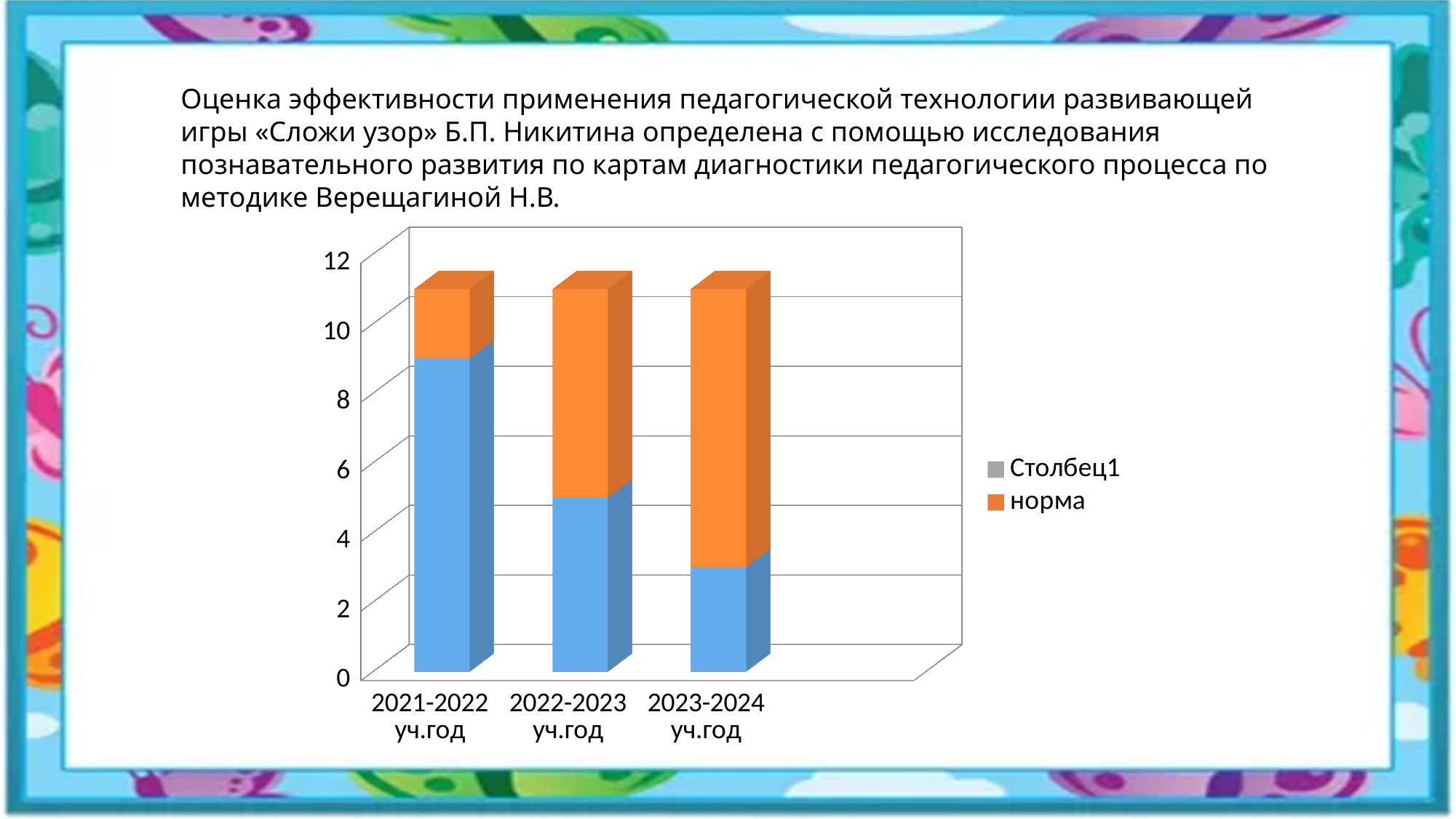
Which academic year has the largest blue segment? 2021-2022 уч.год Is the blue segment for 2022-2023 уч.год greater or less than 6? less Which academic year has the smallest blue segment? 2023-2024 уч.год Which entries appear in the chart legend? Столбец1, норма Is the blue segment for 2023-2024 уч.год greater or less than 4? less How many categories (academic years) are shown on the x axis of the chart? 3 How many series does the chart legend list? 2 Does the blue segment rise or fall from 2021-2022 уч.год to 2023-2024 уч.год? fall Is the total height of the stacked bar for 2022-2023 уч.год greater or less than 10? greater What kind of chart is shown on the slide? bar chart What colour represents the series "норма" in the chart? orange